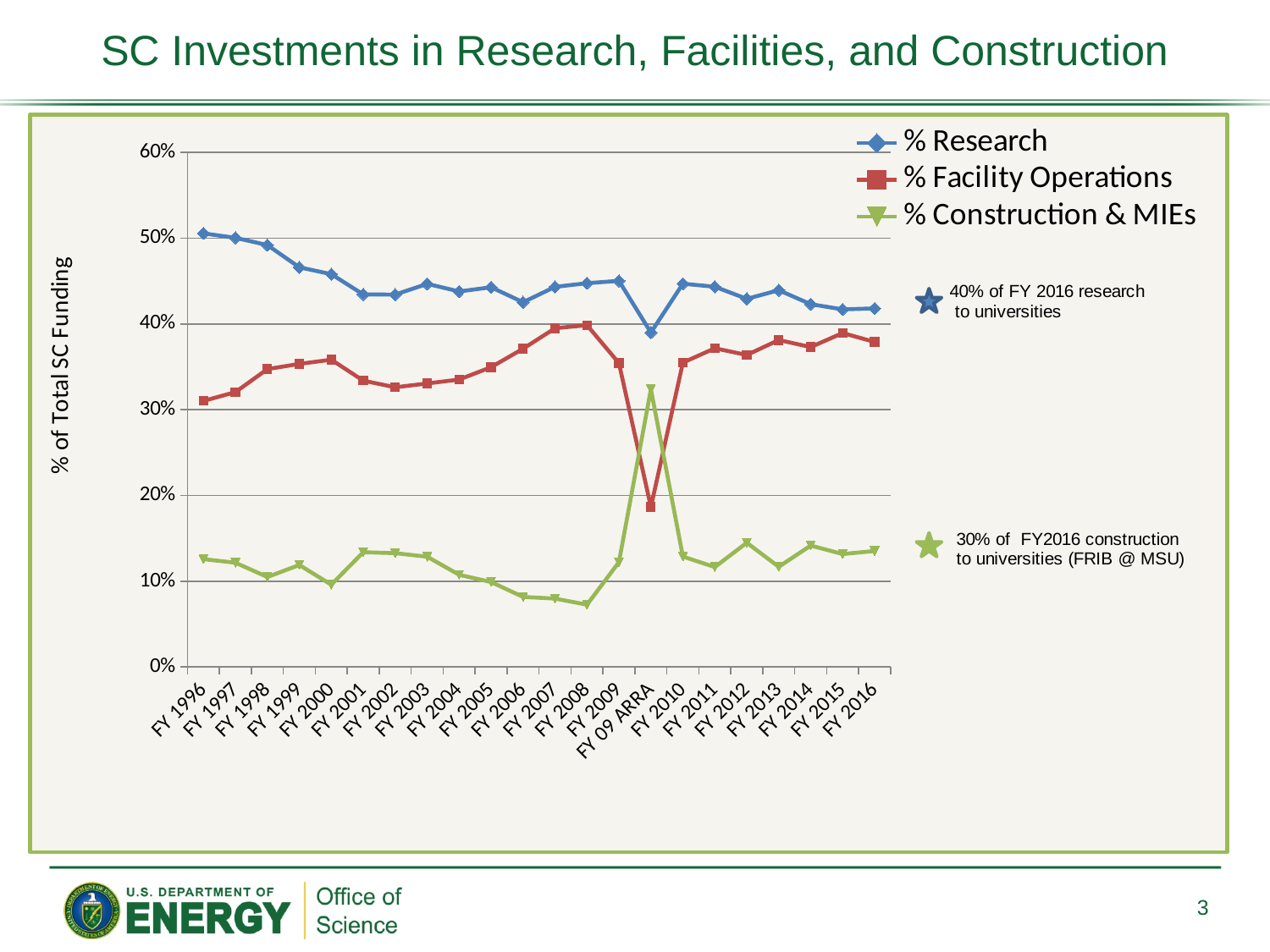
Is the value for % Construction & MIEs in FY 2008 greater or less than 10%? less Is the value for % Construction & MIEs in FY 09 ARRA greater or less than 30%? greater How many fiscal-year categories are plotted along the x axis? 22 Which category has the lowest value for % Research? FY 09 ARRA Is the value for % Facility Operations in FY 09 ARRA greater or less than 20%? less Which category has the highest value for % Construction & MIEs? FY 09 ARRA What is the label on the y axis of the chart? % of Total SC Funding In FY 2016, which is higher, % Research or % Facility Operations? % Research Which category has the lowest value for % Facility Operations? FY 09 ARRA Does the % Research line rise or fall from FY 1996 to FY 2001? fall What kind of chart is shown on the slide? line chart How many series does the legend list? 3